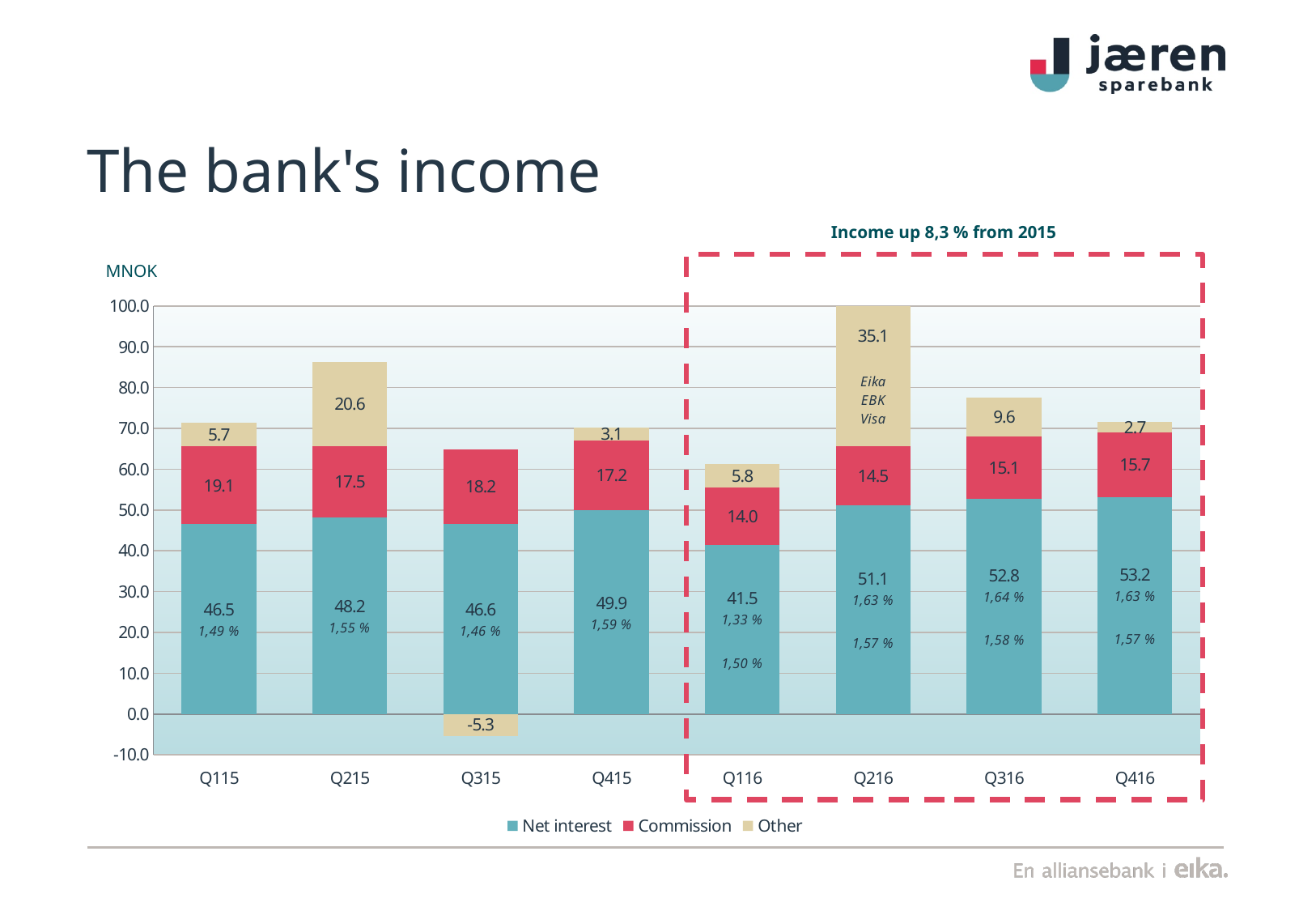
What is the title of the slide? The bank's income How many series does the legend list? 3 What is the Net interest value for Q216? 51.1 How many quarters are shown on the x axis? 8 What is the Commission value for Q115? 19.1 What kind of chart is shown on the slide? Stacked bar chart What is the Other value for Q315? -5.3 Which is larger, the Commission value for Q215 or for Q416? Q215 Which quarter has the lowest Net interest value? Q116 Which quarter has the highest Other value? Q216 What is the total of the stacked bar for Q316? 77.5 What is the difference between the Net interest values for Q416 and Q116? 11.7